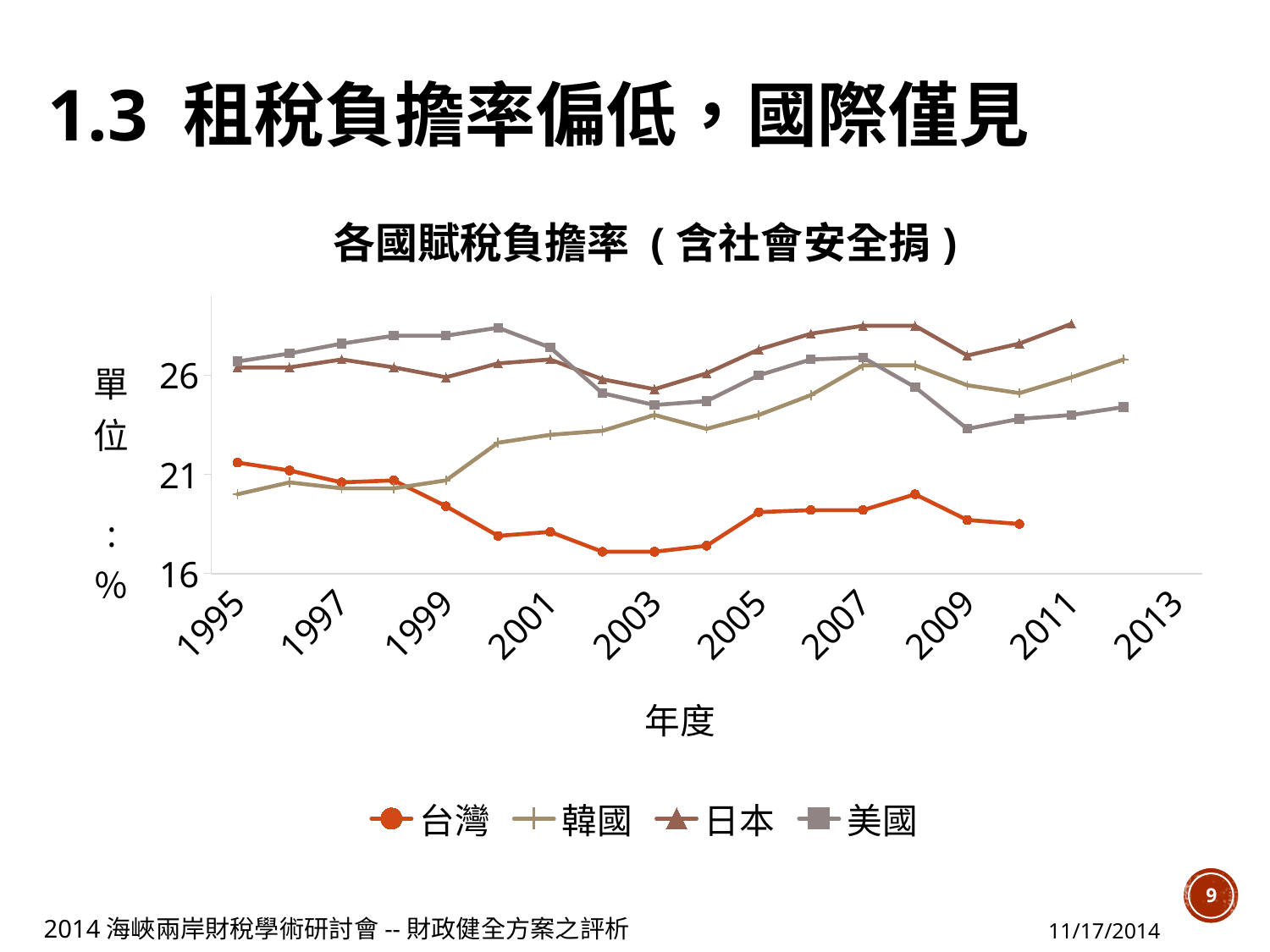
What is the title of the chart? 各國賦稅負擔率（含社會安全捐） In 2009, which is larger, the value for 韓國 or the value for 美國? 韓國 In 2003, which is larger, the value for 台灣 or the value for 日本? 日本 What kind of chart is shown on the slide? line chart What is the label of the x axis? 年度 Does the value for 台灣 rise or fall from 1995 to 2003? fall Is the value for 美國 in 2000 greater or less than 26? greater Is the value for 韓國 in 1995 greater or less than 21? less Which series has the lowest value in 2010? 台灣 How many series does the legend list? 4 Is the value for 美國 in 2009 greater or less than 26? less